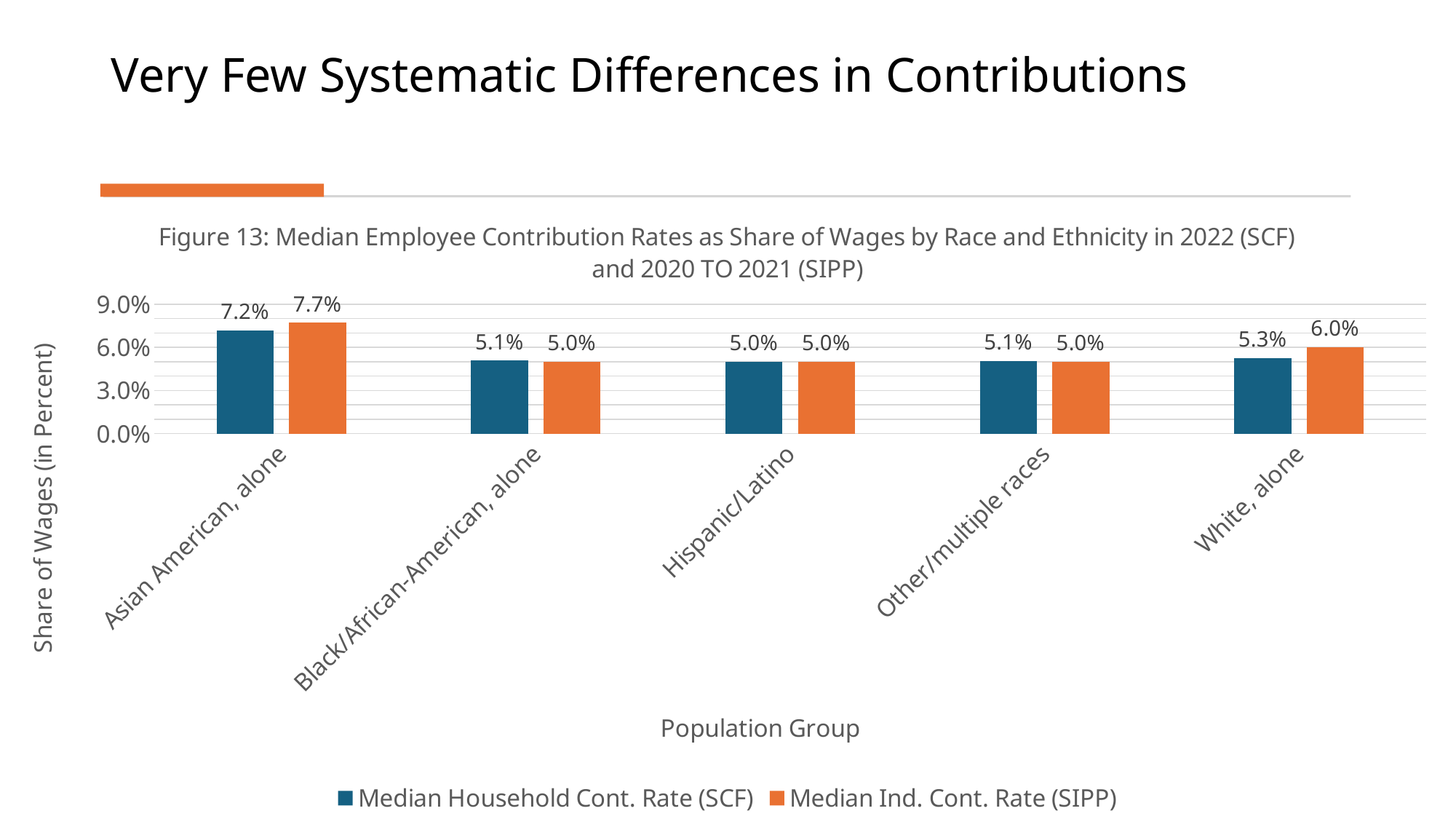
What is the Median Ind. Cont. Rate (SIPP) for White, alone? 6.0% Which population group has the highest Median Ind. Cont. Rate (SIPP)? Asian American, alone What is the difference between the Median Ind. Cont. Rate (SIPP) and the Median Household Cont. Rate (SCF) for White, alone? 0.7% What is the label of the y axis? Share of Wages (in Percent) What is the Median Household Cont. Rate (SCF) for Asian American, alone? 7.2% How many population groups are shown on the x axis? 5 How many series does the legend list? 2 Which population group has the highest Median Household Cont. Rate (SCF)? Asian American, alone What is the Median Household Cont. Rate (SCF) for Other/multiple races? 5.1% For Asian American, alone, which is larger: the Median Household Cont. Rate (SCF) or the Median Ind. Cont. Rate (SIPP)? Median Ind. Cont. Rate (SIPP) What is the Median Ind. Cont. Rate (SIPP) for Black/African-American, alone? 5.0% What kind of chart is shown on the slide? Bar chart